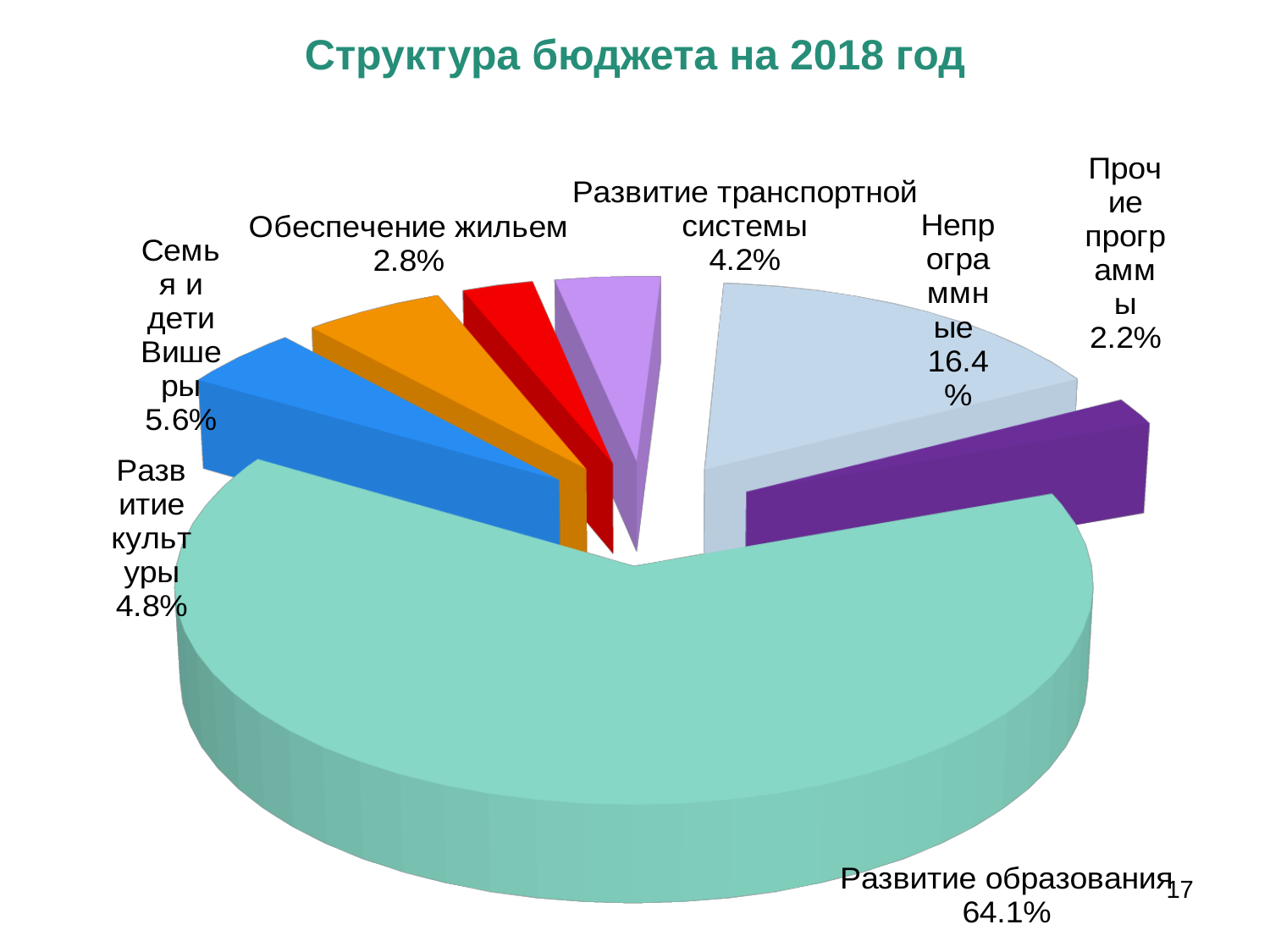
Which category has the largest share of the budget? Развитие образования Which is larger, the share for Семья и дети Вишеры or the share for Развитие культуры? Семья и дети Вишеры What is the title of the chart? Структура бюджета на 2018 год Which category has the smallest share of the budget? Прочие программы What share of the budget goes to Развитие образования? 64.1% What share of the budget is labelled Непрограммные? 16.4% What percentage is shown for Развитие транспортной системы? 4.2% What percentage is shown for Обеспечение жильем? 2.8% What is the difference between the shares of Развитие образования and Непрограммные? 47.7% How many slices does the pie chart have? 7 What is the combined share of Развитие транспортной системы and Обеспечение жильем? 7.0% What type of chart is shown on the slide? Pie chart